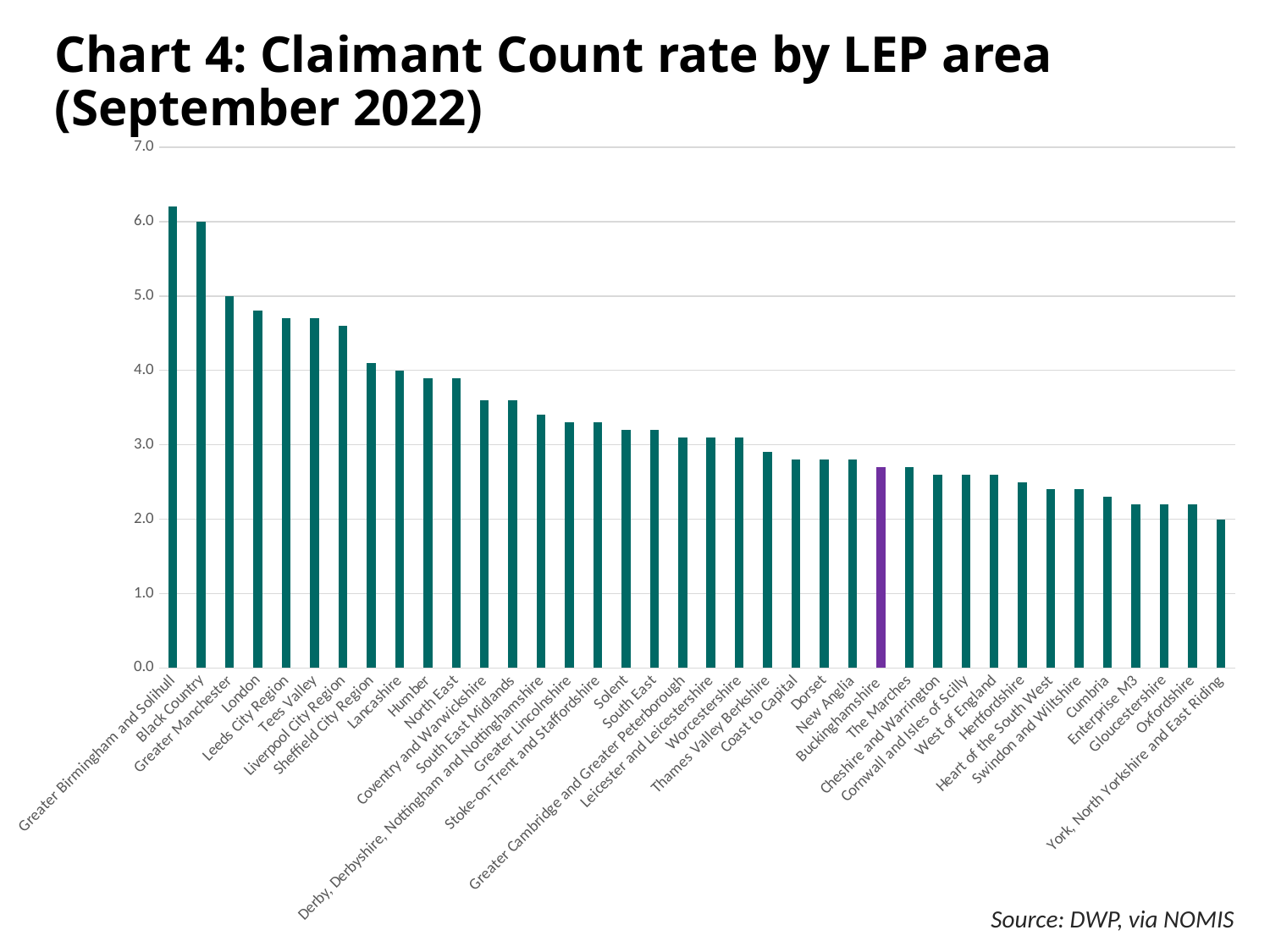
Is the value for Buckinghamshire greater or less than 3.0? less Do the values rise or fall moving from left to right along the x axis? Fall Which has a higher Claimant Count rate, Tees Valley or Humber? Tees Valley What kind of chart is shown on the slide? Bar chart Which LEP area's bar is highlighted in purple? Buckinghamshire Which LEP area has the highest Claimant Count rate? Greater Birmingham and Solihull Is the value for London greater or less than 5.0? less What is the Claimant Count rate for Lancashire? 4.0 What is the Claimant Count rate for Black Country? 6.0 What is the Claimant Count rate for Greater Manchester? 5.0 Which LEP area has the lowest Claimant Count rate? York, North Yorkshire and East Riding What is the Claimant Count rate for York, North Yorkshire and East Riding? 2.0